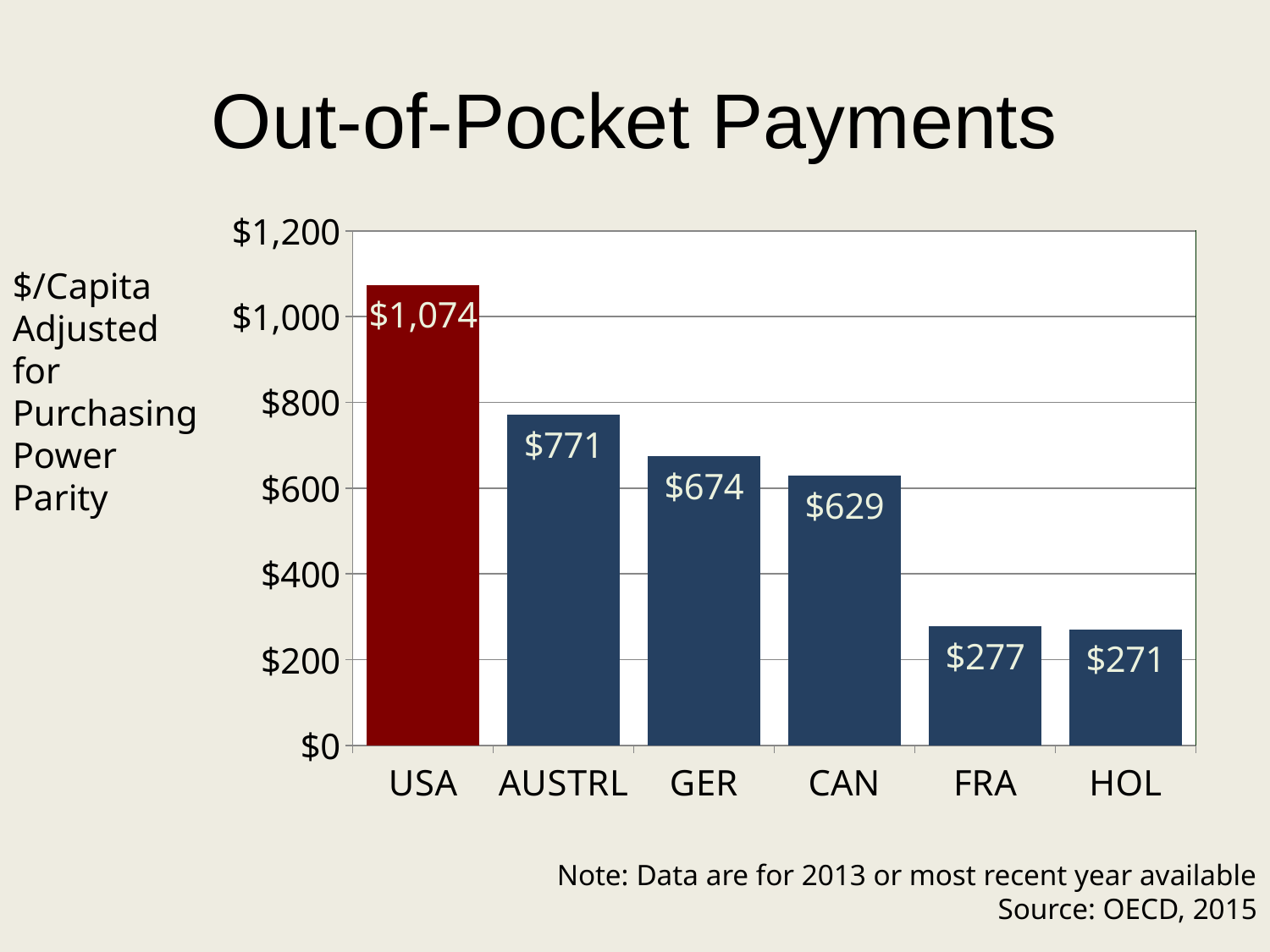
What is the out-of-pocket payment value for HOL? $271 What is the difference between the values for GER and CAN? $45 Is the value for AUSTRL greater or less than $800? less Which bar is coloured differently (dark red) from the others? USA Which country has the lowest out-of-pocket payments? HOL What is the out-of-pocket payment value for USA? $1,074 What is the difference between the values for USA and AUSTRL? $303 Which has a larger value, CAN or FRA? CAN What kind of chart is shown on the slide? bar chart What is the out-of-pocket payment value for GER? $674 How many countries are shown in the chart? 6 Which country has the highest out-of-pocket payments? USA